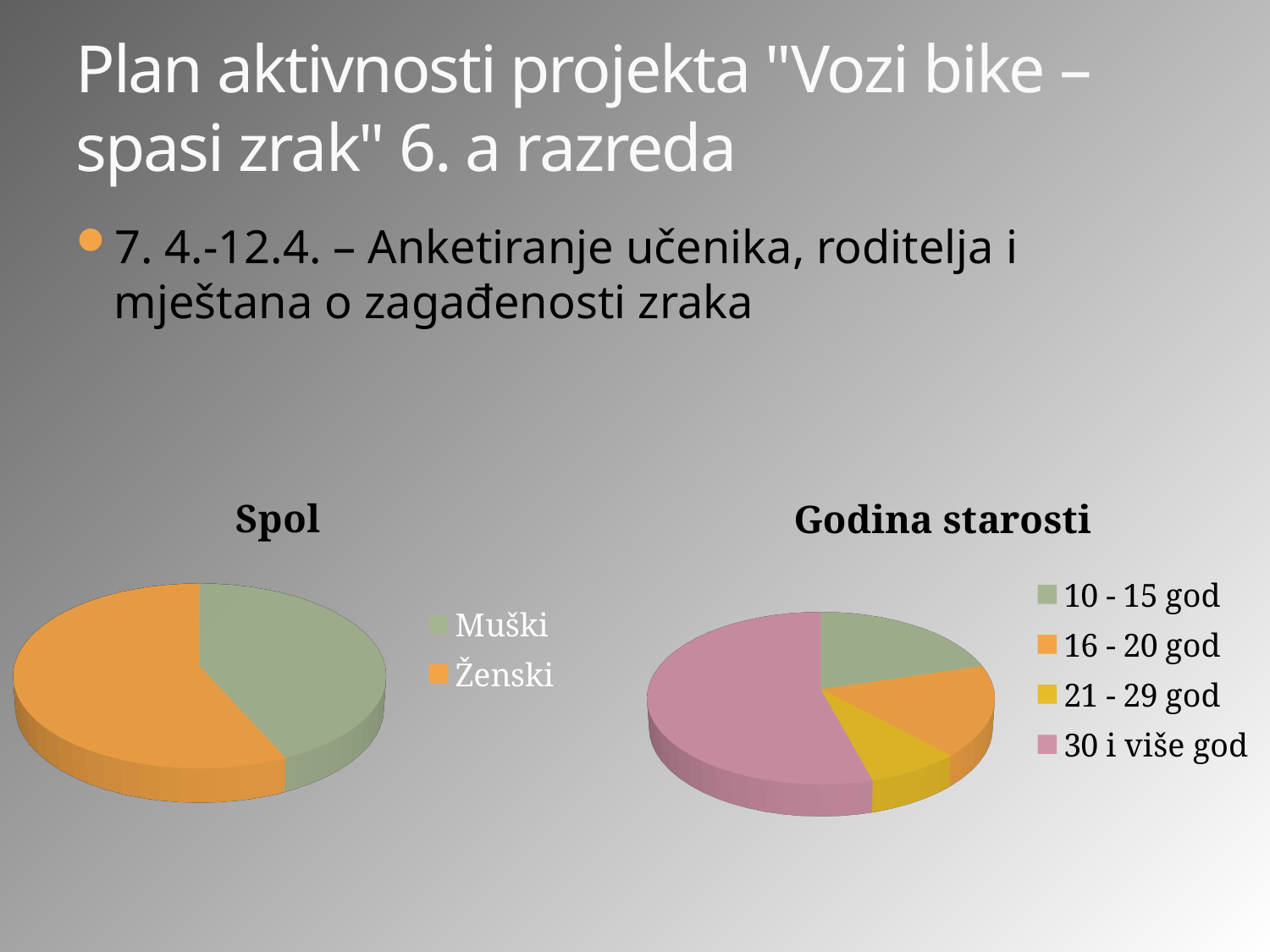
In the "Godina starosti" chart, which age group has the largest slice? 30 i više god In the "Spol" chart, which category has the smallest slice? Muški In the "Godina starosti" chart, which slice is larger, 30 i više god or 16 - 20 god? 30 i više god In the "Godina starosti" chart, which age group has the smallest slice? 21 - 29 god In the "Spol" chart, how many categories does the legend list? 2 What kind of chart is the "Godina starosti" chart? pie chart What is the title of the pie chart on the left of the slide? Spol In the "Godina starosti" chart, how many categories does the legend list? 4 In the "Spol" chart, which slice is larger, Muški or Ženski? Ženski What kind of chart is the "Spol" chart? pie chart In the "Spol" chart, which category has the largest slice? Ženski In the "Godina starosti" chart, what colour is the slice for 21 - 29 god? yellow